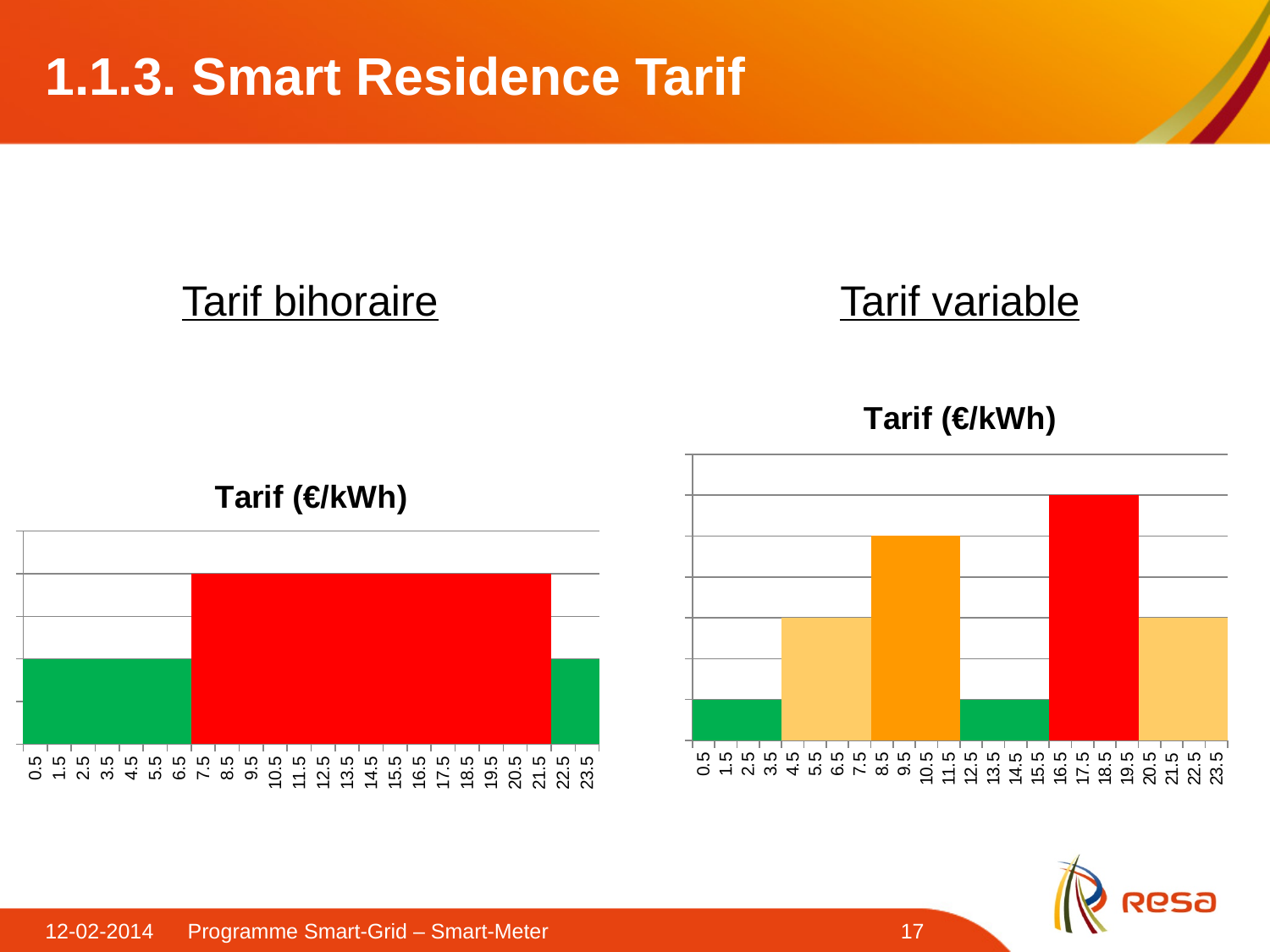
In the Tarif variable chart, which hour range has the highest tariff? 16.5 to 19.5 What kind of chart is the Tarif variable chart on the right? bar chart How many x-axis categories (hours) does the Tarif bihoraire chart show? 24 In the Tarif bihoraire chart, what colour are the bars from 7.5 to 21.5? red In the Tarif bihoraire chart, which is larger: the value at 22.5 or the value at 15.5? 15.5 In the Tarif variable chart, which is larger: the value at 9.5 or the value at 21.5? 9.5 In the Tarif bihoraire chart, which is larger: the value at 10.5 or the value at 2.5? 10.5 In the Tarif variable chart, do the values rise or fall going from 15.5 to 16.5? rise How many x-axis categories (hours) does the Tarif variable chart show? 24 What kind of chart is the Tarif bihoraire chart on the left? bar chart What is the title shown above each of the two charts? Tarif (€/kWh)